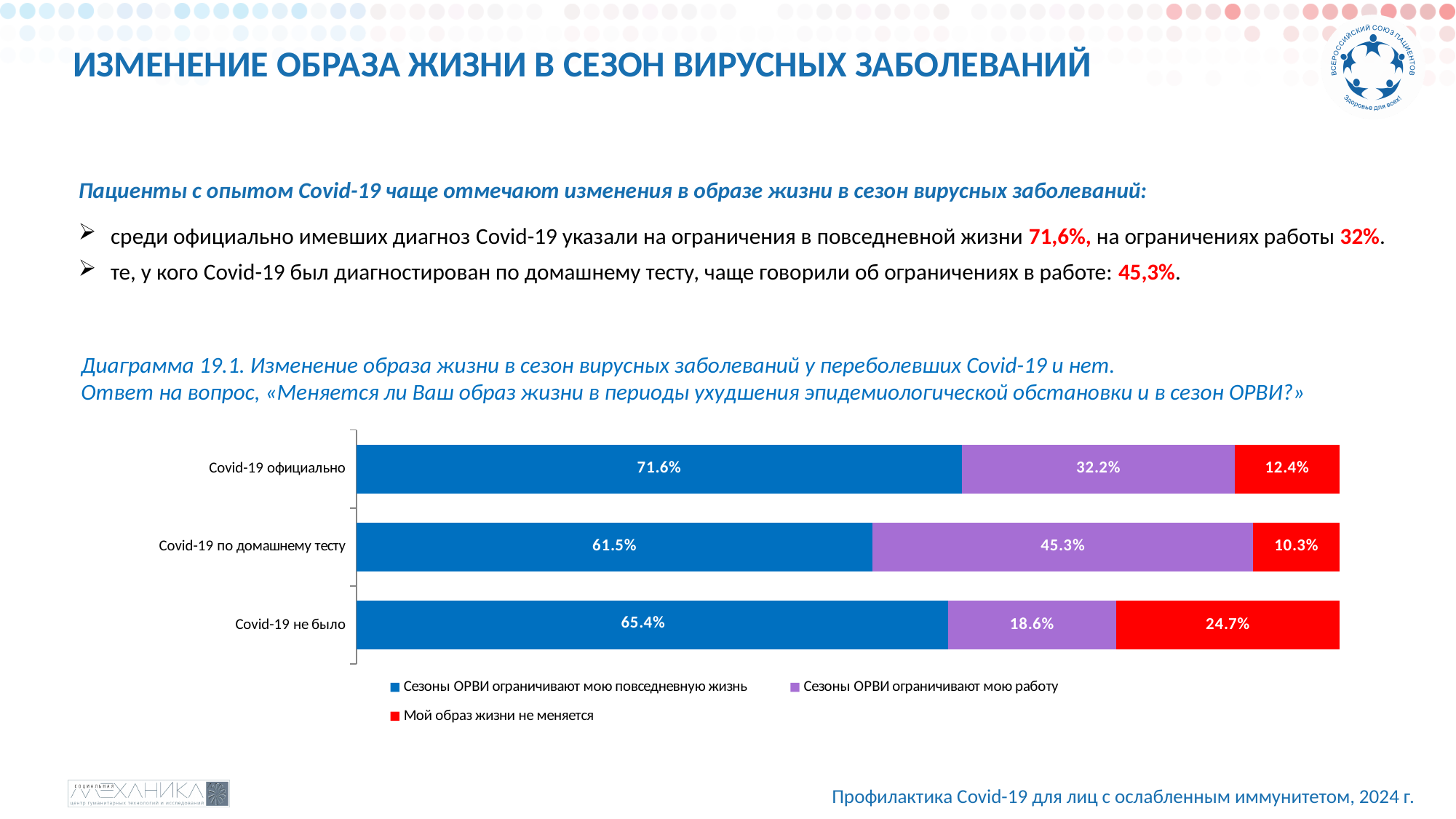
Which is larger: the "Мой образ жизни не меняется" value for "Covid-19 официально" or for "Covid-19 не было"? Covid-19 не было Which category has the lowest value for "Мой образ жизни не меняется"? Covid-19 по домашнему тесту What is the difference between the "Сезоны ОРВИ ограничивают мою работу" values for "Covid-19 по домашнему тесту" and "Covid-19 не было"? 26.7% How many series does the legend list? 3 What kind of chart is shown on the slide? Stacked bar chart How many categories are plotted on the chart? 3 What is the value of "Сезоны ОРВИ ограничивают мою повседневную жизнь" for "Covid-19 официально"? 71.6% What is the value of "Сезоны ОРВИ ограничивают мою работу" for "Covid-19 по домашнему тесту"? 45.3% Which category has the highest value for "Сезоны ОРВИ ограничивают мою повседневную жизнь"? Covid-19 официально What is the total of the three segments in the "Covid-19 не было" bar? 108.7% What is the value of "Мой образ жизни не меняется" for "Covid-19 не было"? 24.7% Which colour represents the series "Мой образ жизни не меняется" in the legend? Red